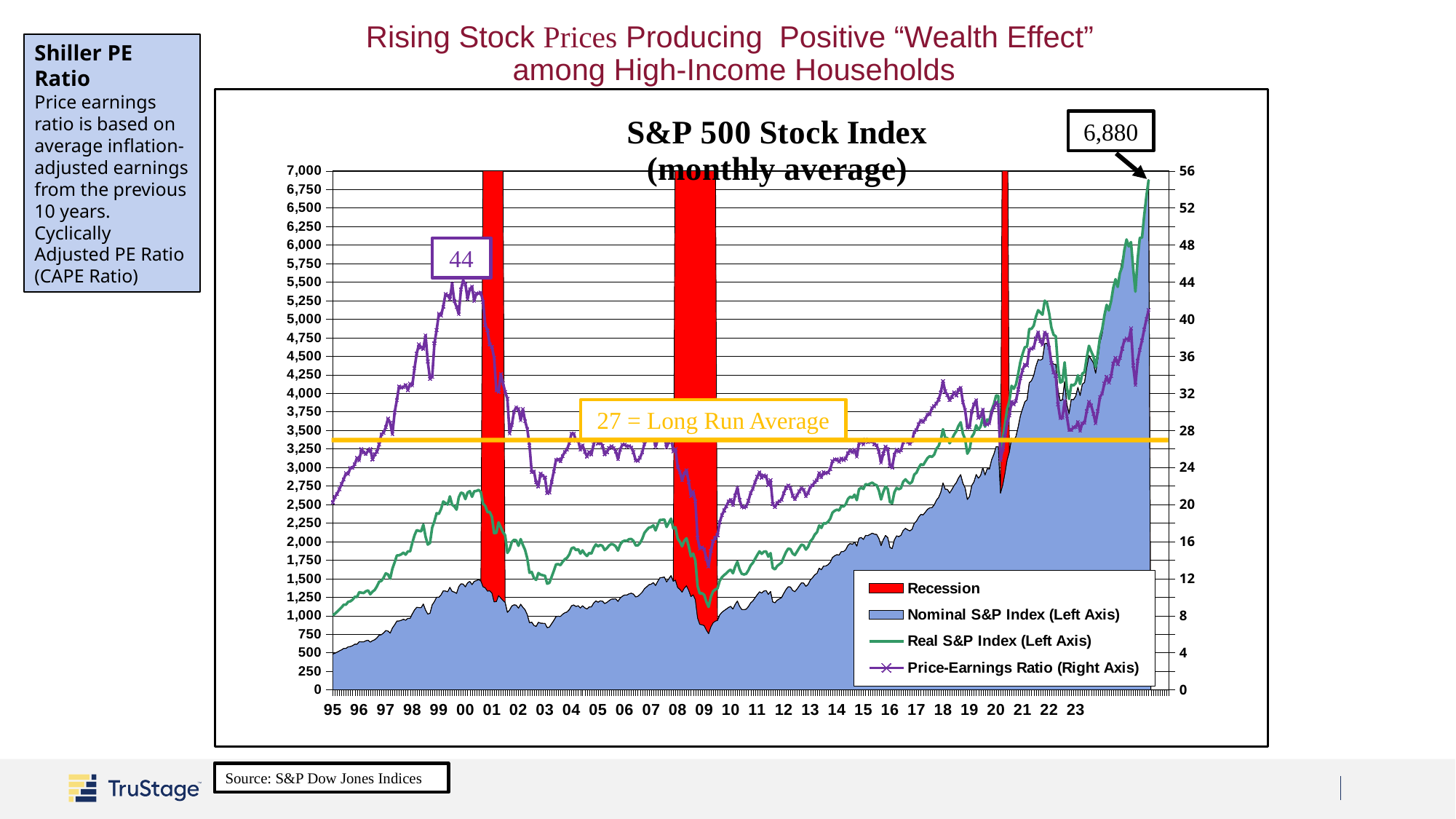
Is the Nominal S&P Index at its 2009 low greater or less than 1,000? less How many recession periods are shaded on the chart? 3 What value is given as the long run average of the Price-Earnings Ratio? 27 Does the Nominal S&P Index overall rise or fall from 95 to 23? rise What is the labelled latest value of the Nominal S&P Index at the right end of the chart? 6,880 Is the Price-Earnings Ratio at its 2009 low greater or less than 20? less On which axis is the Price-Earnings Ratio plotted? Right axis What is the title of the chart? S&P 500 Stock Index (monthly average) What kind of chart is used to plot the Real S&P Index and the Price-Earnings Ratio? line chart How many series does the chart's legend list? 4 What is the labelled peak value of the Price-Earnings Ratio around 2000? 44 Is the Real S&P Index at the right end of the chart greater or less than 6,000? greater